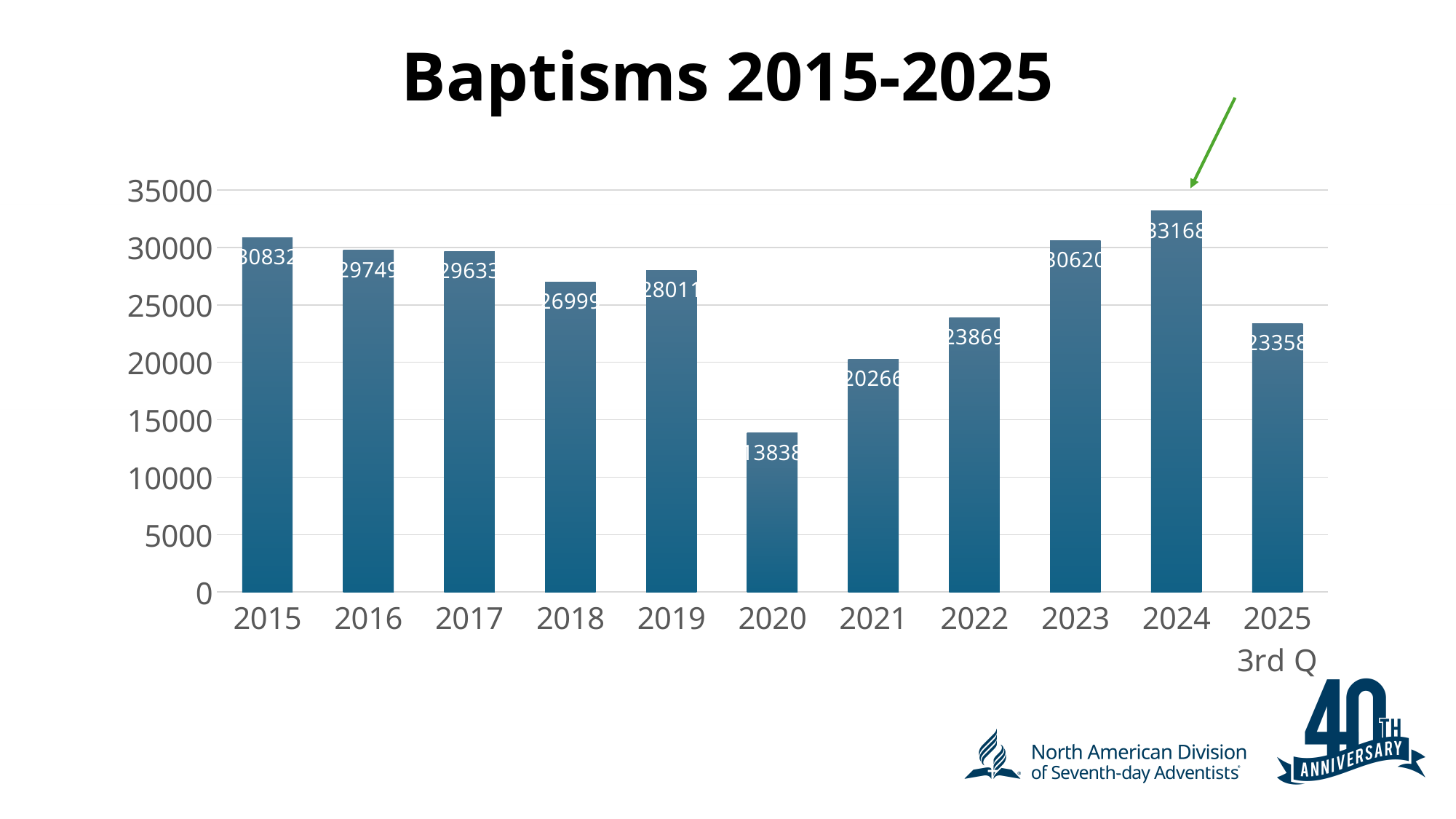
What is the value for 2020? 13838 Is the value for 2021 greater or less than 25000? less Which is larger, the value for 2018 or the value for 2019? 2019 What is the value for 2024? 33168 What is the title of the chart? Baptisms 2015-2025 What kind of chart is shown on the slide? bar chart How many bars are shown in the chart? 11 What is the value for 2025 3rd Q? 23358 What is the difference between the values for 2024 and 2023? 2548 Do the values rise or fall from 2020 to 2024? rise Which year has the lowest number of baptisms? 2020 Which year has the highest number of baptisms? 2024